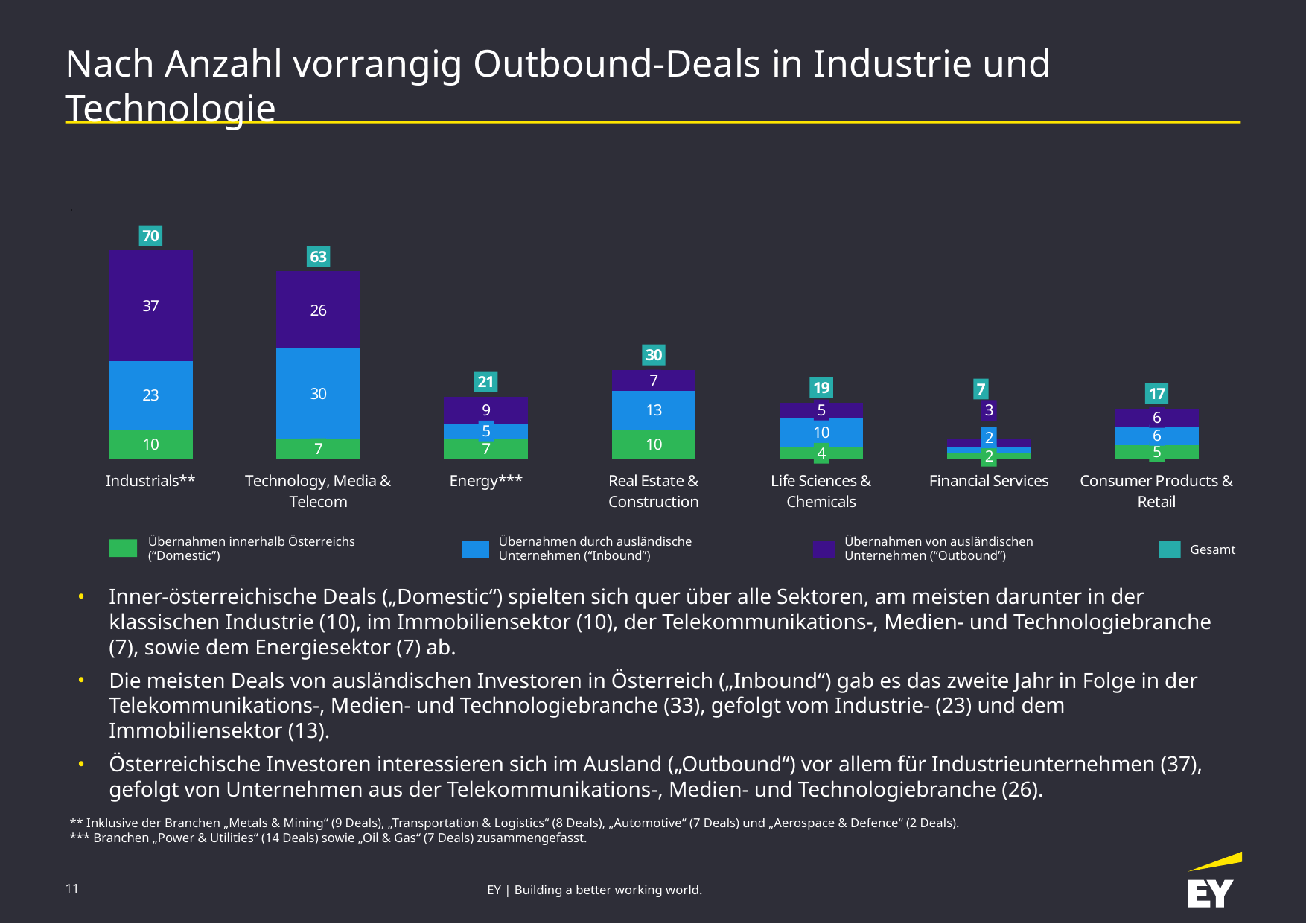
What is the Inbound value for Technology, Media & Telecom? 30 What is the total (Gesamt) value shown for Energy***? 21 Which sector has the highest total (Gesamt) value? Industrials** What is the Domestic value for Real Estate & Construction? 10 Which is larger: the Inbound value for Life Sciences & Chemicals or the Inbound value for Consumer Products & Retail? Life Sciences & Chemicals How many entries does the chart's legend list? 4 How many sectors (categories) are shown on the x axis of the chart? 7 What is the Outbound value for Industrials**? 37 Which colour represents the Domestic series (Übernahmen innerhalb Österreichs) in the chart? Green What is the difference between the total for Industrials** and the total for Technology, Media & Telecom? 7 What type of chart is shown on the slide? Stacked bar chart Which sector has the lowest total (Gesamt) value? Financial Services